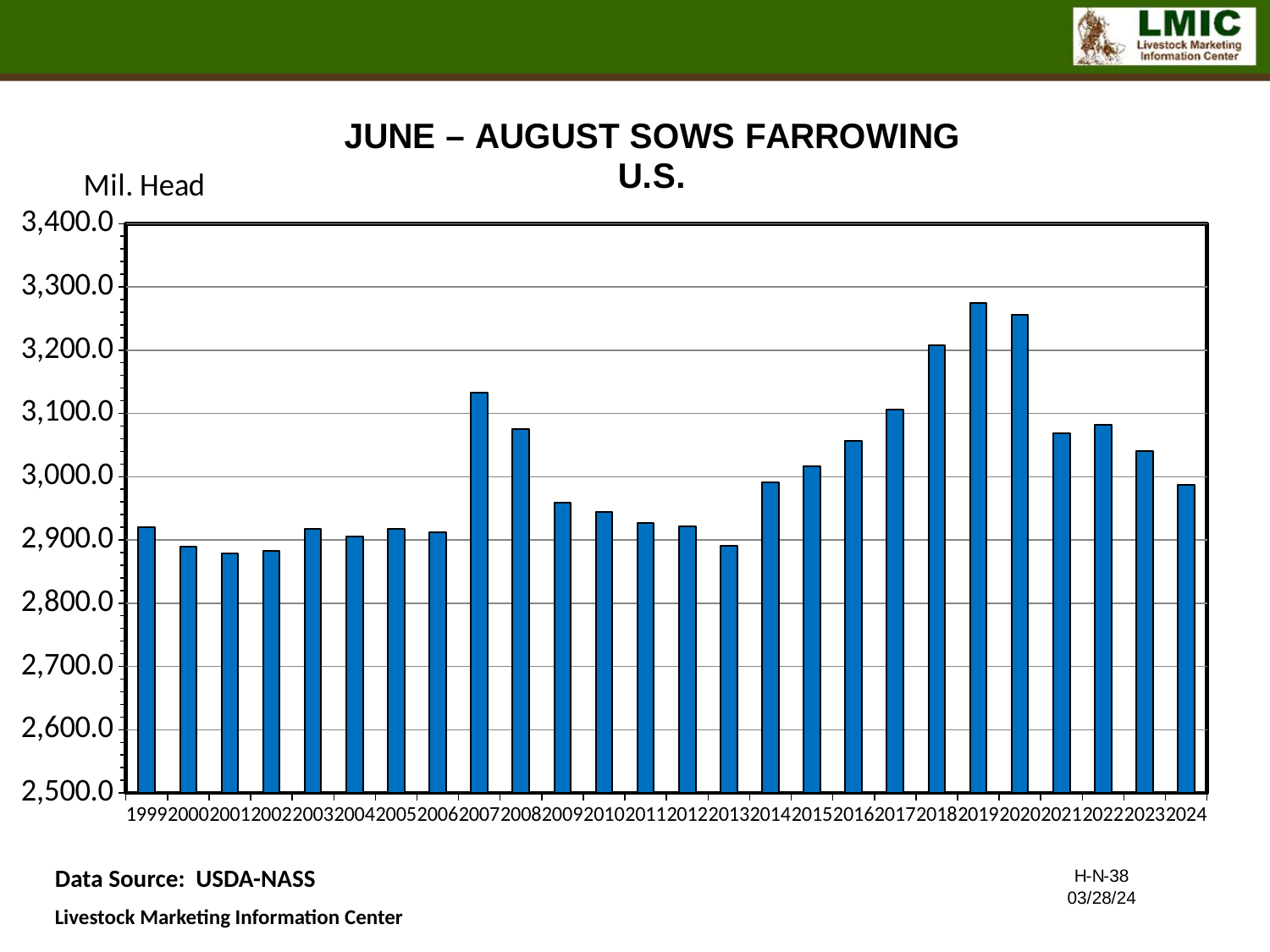
Is the value for 2024 greater or less than 3,000.0? less Which year has the highest June–August sows farrowing value? 2019 Do the values rise or fall from 2013 to 2019? rise Is the value for 2023 greater or less than 3,000.0? greater Which year has the larger value, 2007 or 2008? 2007 Is the value for 2007 greater or less than 3,100.0? greater How many years are plotted on the x axis of the chart? 26 What unit label is shown above the y axis of the chart? Mil. Head What kind of chart is shown on the slide? bar chart Which year has the larger value, 2020 or 2021? 2020